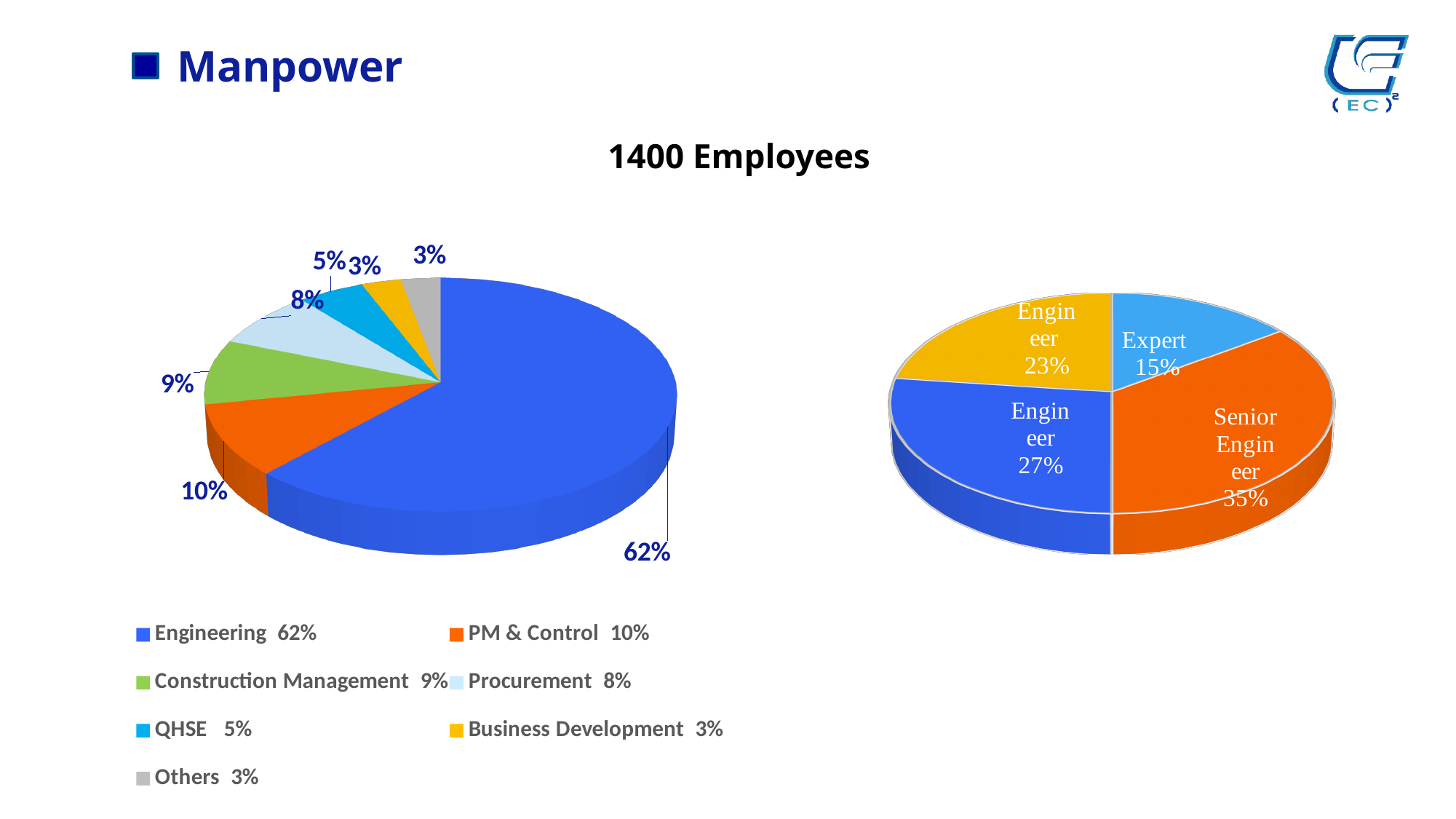
How many categories does the legend of the left pie chart list? 7 In the left pie chart, which category has the largest share? Engineering In the right pie chart, what percentage is shown for Senior Engineer? 35% In the left pie chart, what share of employees is in Engineering? 62% What type of chart is shown on the left of the slide? Pie chart In the left pie chart, what percentage is shown for Procurement? 8% In the left pie chart, which is larger, Construction Management or QHSE? Construction Management In the left pie chart, what percentage is shown for PM & Control? 10% In the left pie chart, what is the difference between the Engineering share and the PM & Control share? 52% In the right pie chart, which is larger, Senior Engineer or Expert? Senior Engineer In the right pie chart, what percentage is shown for Expert? 15% What is the title shown above the charts on the slide? 1400 Employees